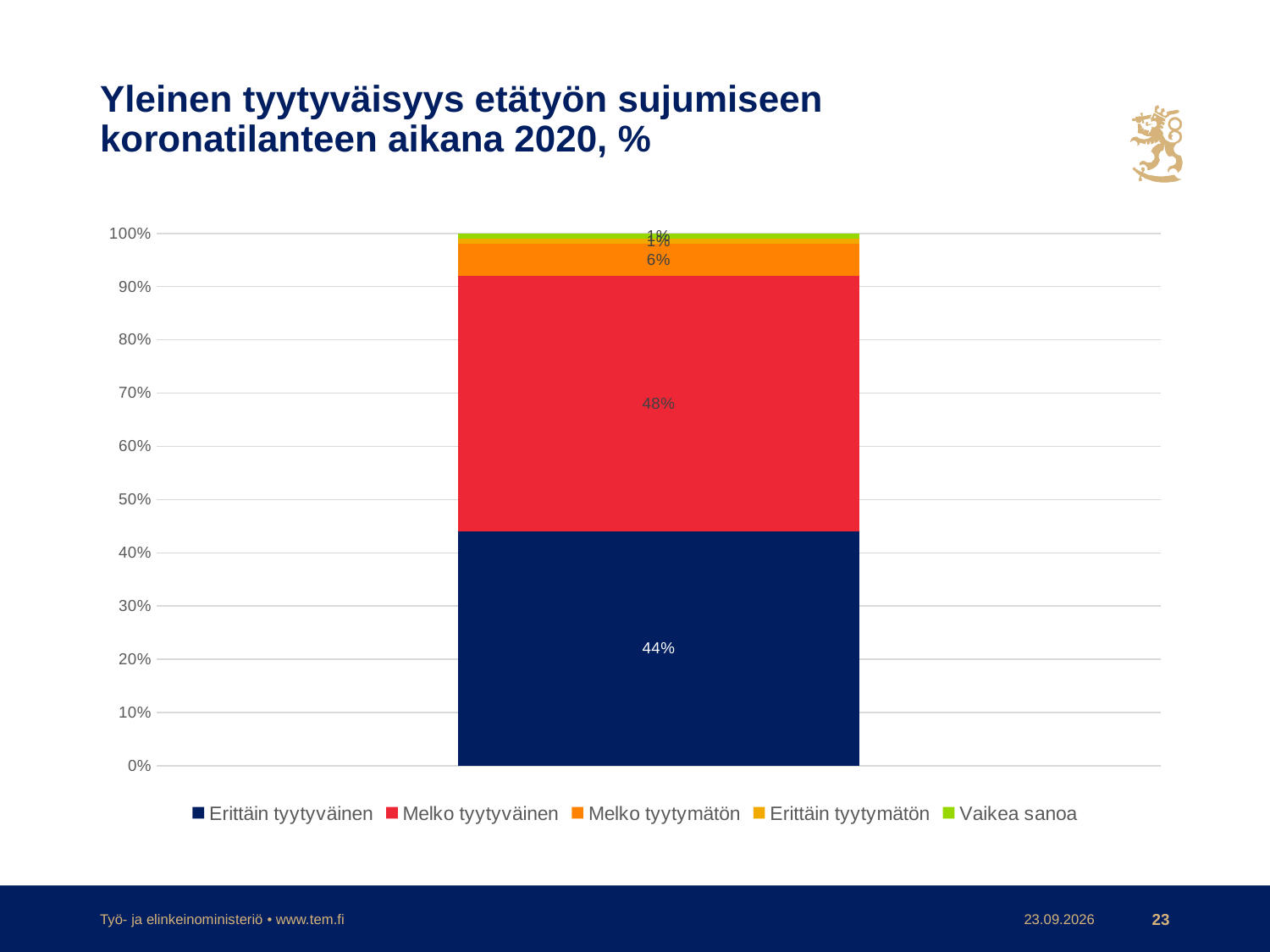
What kind of chart is shown on the slide? Stacked bar chart What is the difference between the 'Melko tyytyväinen' share and the 'Erittäin tyytyväinen' share? 4% Is the value for 'Melko tyytymätön' greater or less than 10%? less What percentage of respondents were 'Erittäin tyytyväinen'? 44% How many series does the legend list? 5 What is the difference between the 'Melko tyytyväinen' share and the 'Melko tyytymätön' share? 42% What is the combined share of 'Erittäin tyytyväinen' and 'Melko tyytyväinen'? 92% What percentage of respondents were 'Melko tyytyväinen'? 48% Which response category has the largest share in the stacked bar? Melko tyytyväinen What colour represents 'Erittäin tyytyväinen' in the chart? Dark blue What percentage of respondents were 'Melko tyytymätön'? 6% Which is larger, the share for 'Erittäin tyytyväinen' or for 'Melko tyytyväinen'? Melko tyytyväinen